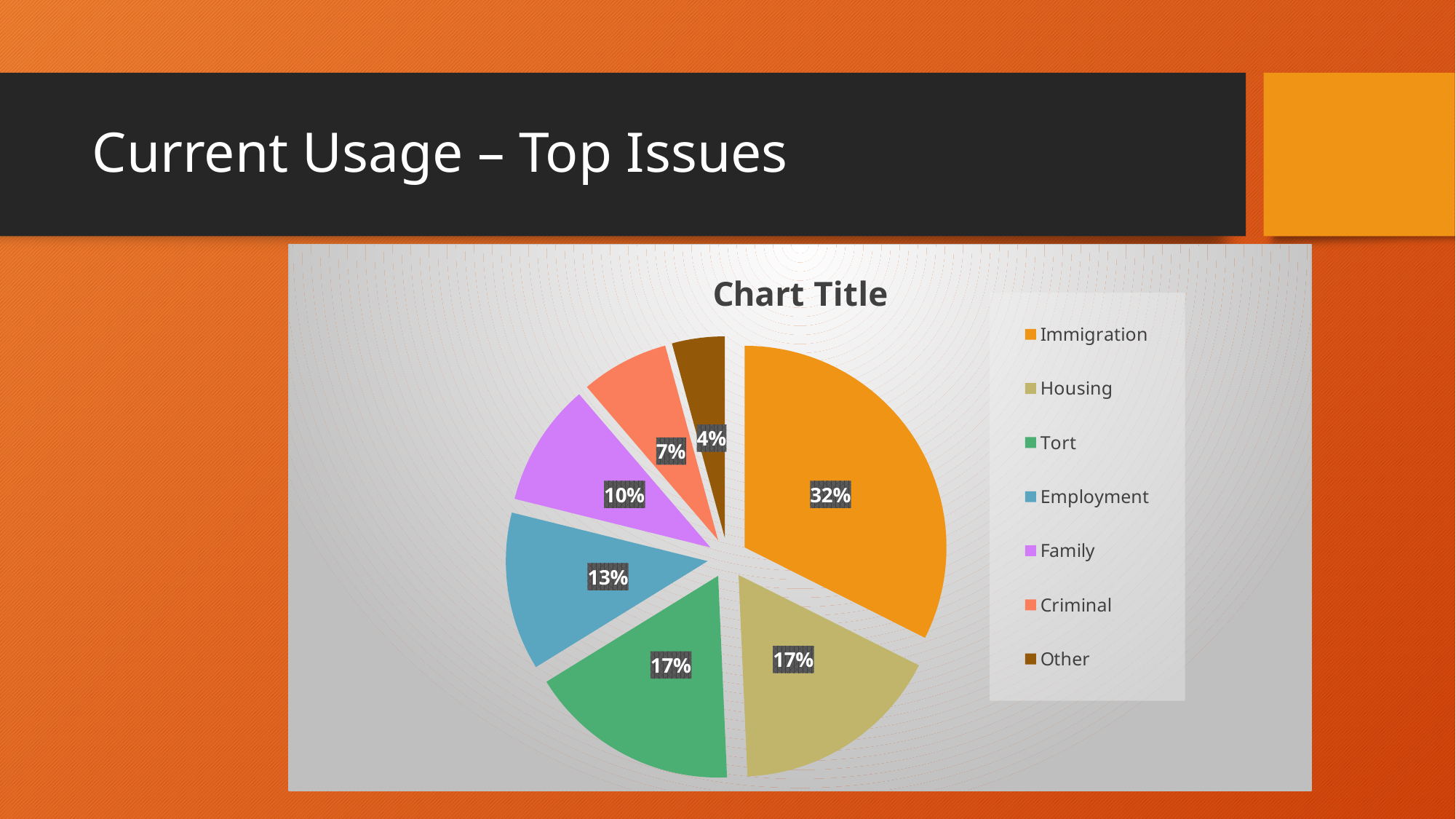
What kind of chart is shown on the slide? Pie chart What percentage is shown for Employment? 13% What is the difference in percentage points between Immigration and Employment? 19 Which is larger, the share for Family or the share for Criminal? Family What percentage is shown for Family? 10% How many categories does the legend list? 7 What is the title shown above the pie chart? Chart Title What percentage is shown for Criminal? 7% What share of the pie does Immigration represent? 32% What percentage is shown for Other? 4% Which category has the largest slice of the pie? Immigration Which category has the smallest slice of the pie? Other